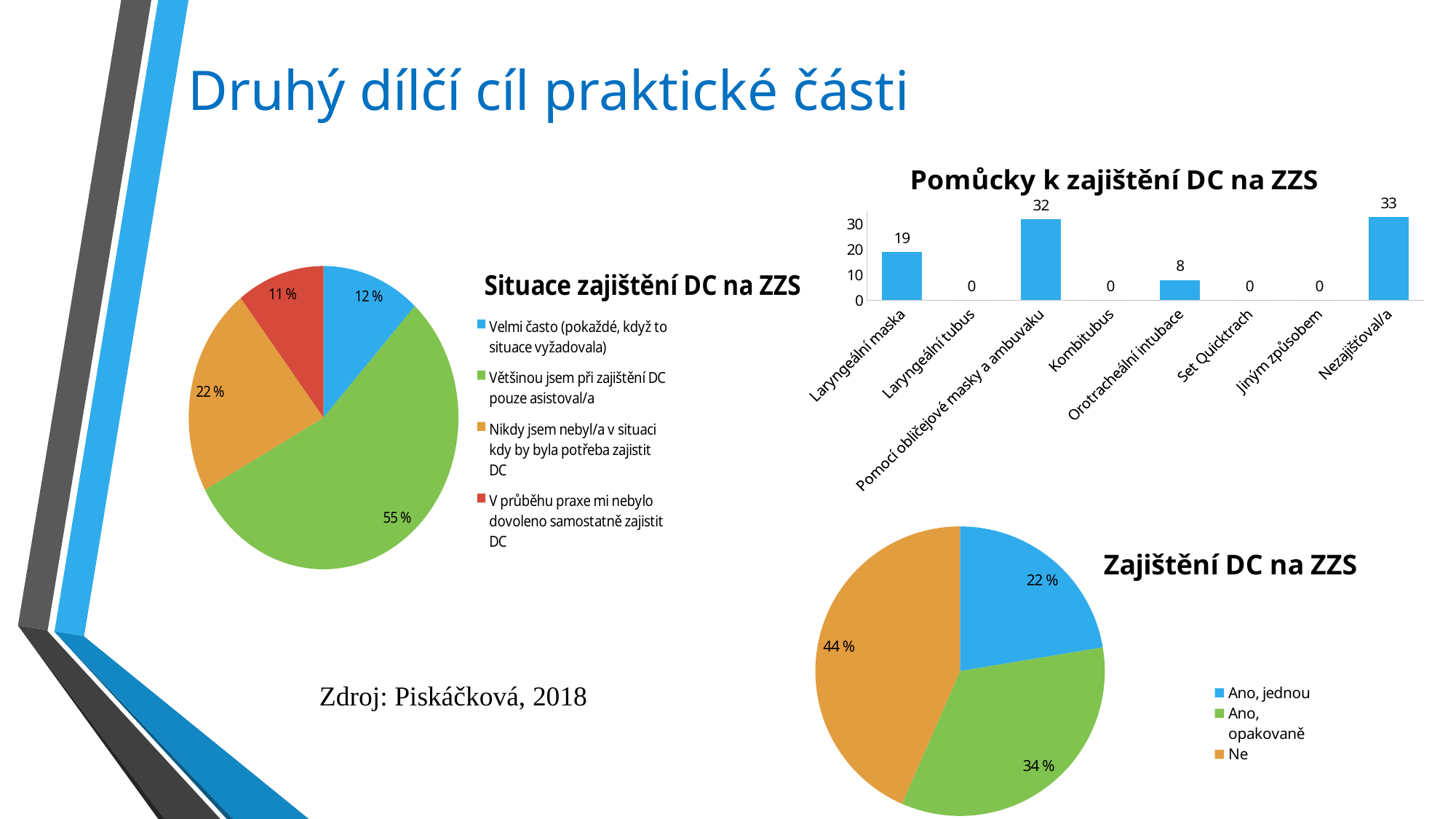
In the 'Pomůcky k zajištění DC na ZZS' chart, which category has the highest value? Nezajišťoval/a In the 'Pomůcky k zajištění DC na ZZS' chart, how many categories are shown on the x axis? 8 In the 'Zajištění DC na ZZS' pie chart, what share is 'Ne'? 44 % In the 'Pomůcky k zajištění DC na ZZS' chart, what is the value for Laryngeální maska? 19 In the 'Situace zajištění DC na ZZS' pie chart, which category has the smallest share? V průběhu praxe mi nebylo dovoleno samostatně zajistit DC How many legend entries does the 'Situace zajištění DC na ZZS' pie chart list? 4 In the 'Pomůcky k zajištění DC na ZZS' chart, how many categories have a value of 0? 4 In the 'Zajištění DC na ZZS' pie chart, which is larger: 'Ano, jednou' or 'Ano, opakovaně'? Ano, opakovaně In the 'Situace zajištění DC na ZZS' pie chart, what share is 'Většinou jsem při zajištění DC pouze asistoval/a'? 55 % In the 'Pomůcky k zajištění DC na ZZS' chart, what is the value for Orotracheální intubace? 8 What kind of chart is 'Pomůcky k zajištění DC na ZZS'? bar chart In the 'Pomůcky k zajištění DC na ZZS' chart, what is the difference between Nezajišťoval/a and Pomocí obličejové masky a ambuvaku? 1